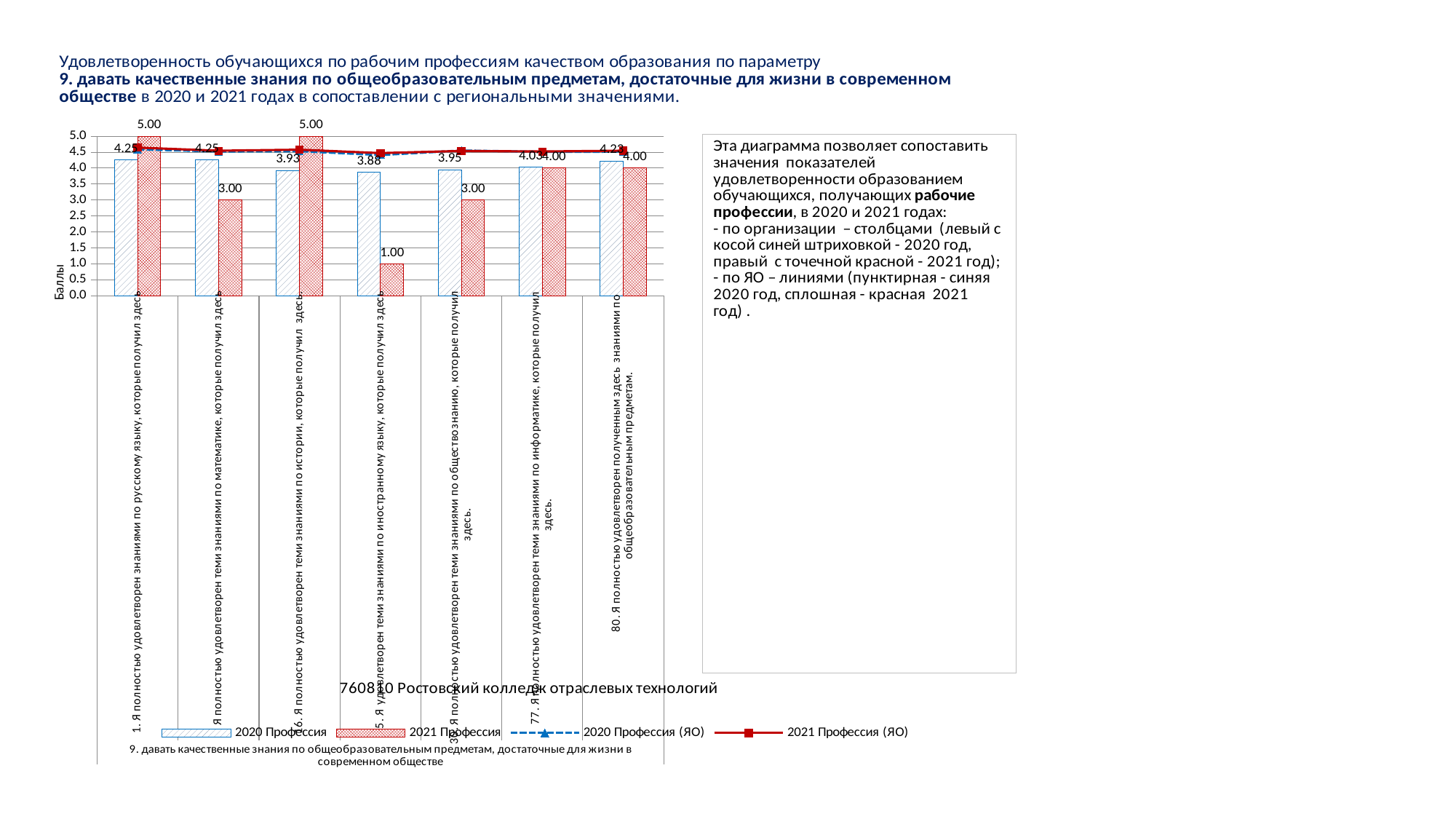
Which category has the lowest 2021 Профессия value? 25. Я удовлетворен теми знаниями по иностранному языку, которые получил здесь For the category about the Russian language (русскому языку), what is the difference between the 2021 Профессия and 2020 Профессия values? 0.75 What is the 2020 Профессия value for the category about knowledge of history (истории)? 3.93 What kind of chart is shown on the slide? A combined bar and line chart How many series does the chart legend list? 4 What is the title of the vertical axis? Баллы Which category has the lowest 2020 Профессия value? 25. Я удовлетворен теми знаниями по иностранному языку, которые получил здесь Is the 2021 Профессия (ЯО) line value for the category about the Russian language (русскому языку) greater or less than 4.0? greater What is the 2020 Профессия value for the category about knowledge of informatics (информатике)? 4.03 How many categories (questions) are plotted along the x axis? 7 What is the 2021 Профессия value for the category about knowledge of a foreign language (иностранному языку)? 1.00 For the category about mathematics (математике), which is larger: the 2020 Профессия value or the 2021 Профессия value? 2020 Профессия